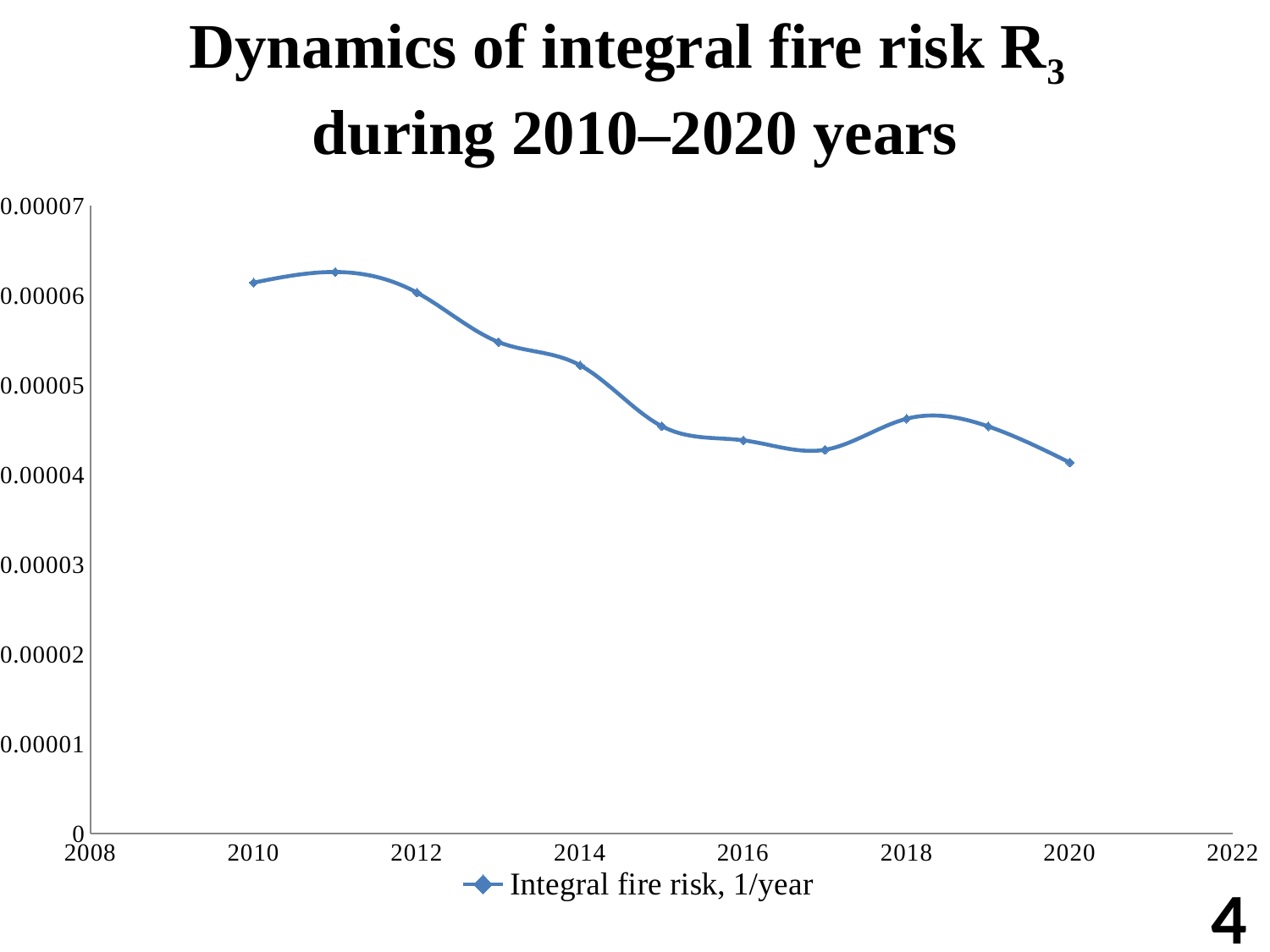
Is the value for 2013 greater or less than 0.00006? less How many series does the legend list? 1 What kind of chart is shown on the slide? line chart In which year is the integral fire risk highest? 2011 How many data points are plotted on the line? 11 Is the value for 2010 greater or less than 0.00006? greater Overall, does the integral fire risk rise or fall from 2010 to 2020? fall Is the value for 2020 greater or less than 0.00004? greater Which year has the larger integral fire risk, 2012 or 2015? 2012 What is the legend entry for the plotted series? Integral fire risk, 1/year In which year is the integral fire risk lowest? 2020